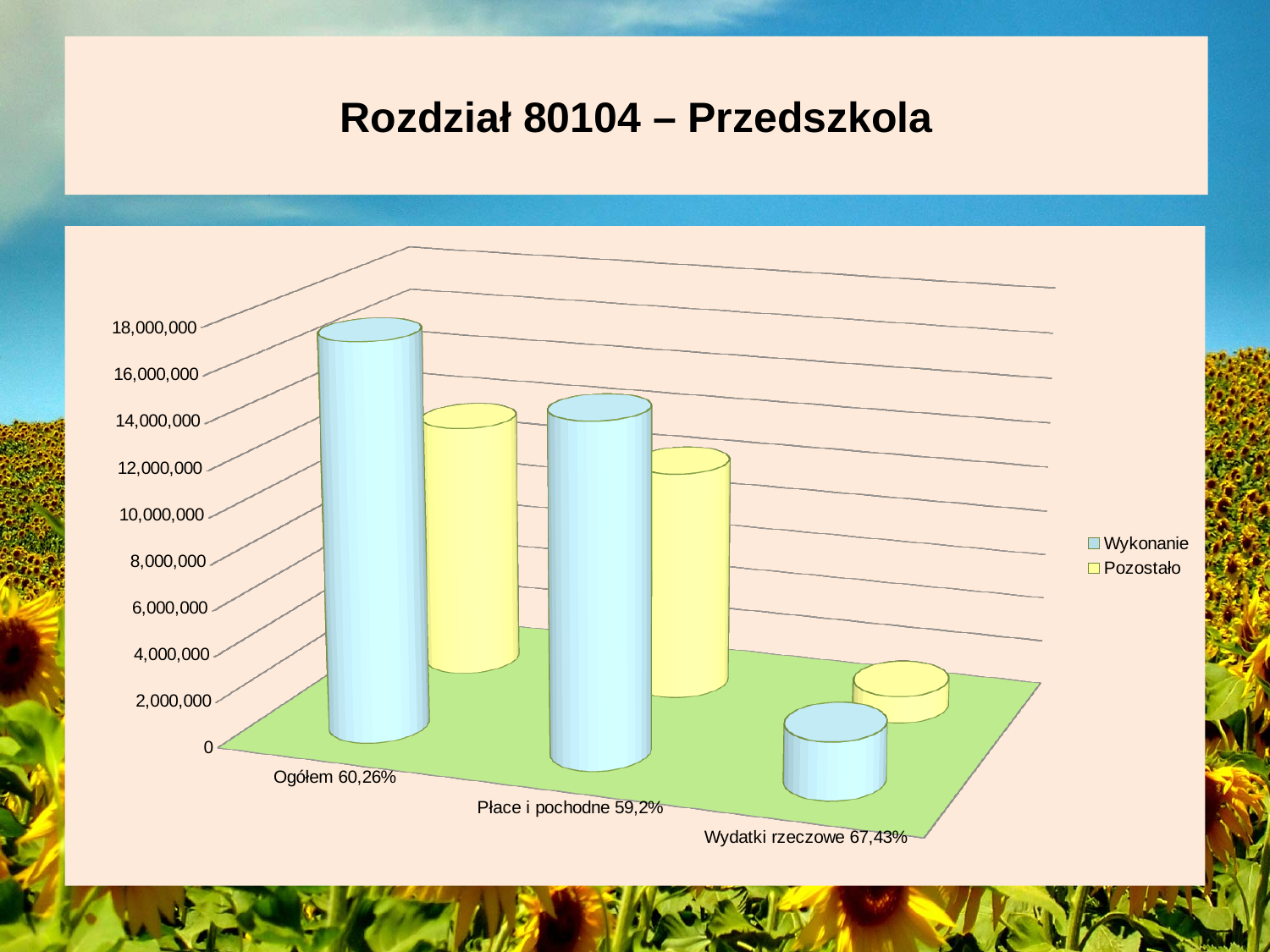
Is the Pozostało value for Płace i pochodne 59,2% greater or less than 4,000,000? greater Which category has the highest Wykonanie value? Ogółem 60,26% How many categories are shown on the x axis of the chart? 3 Do the Wykonanie values rise or fall moving from Ogółem to Wydatki rzeczowe along the x axis? fall What is the title of the slide containing the chart? Rozdział 80104 – Przedszkola Is the Wykonanie value for Wydatki rzeczowe 67,43% greater or less than 6,000,000? less Which series is shown in yellow in the chart legend? Pozostało How many series does the chart legend list? 2 Which category has the lowest Pozostało value? Wydatki rzeczowe 67,43% What kind of chart is shown on the slide? bar chart Is the Wykonanie value for Ogółem 60,26% greater or less than 10,000,000? greater For the category Ogółem 60,26%, which is larger: Wykonanie or Pozostało? Wykonanie